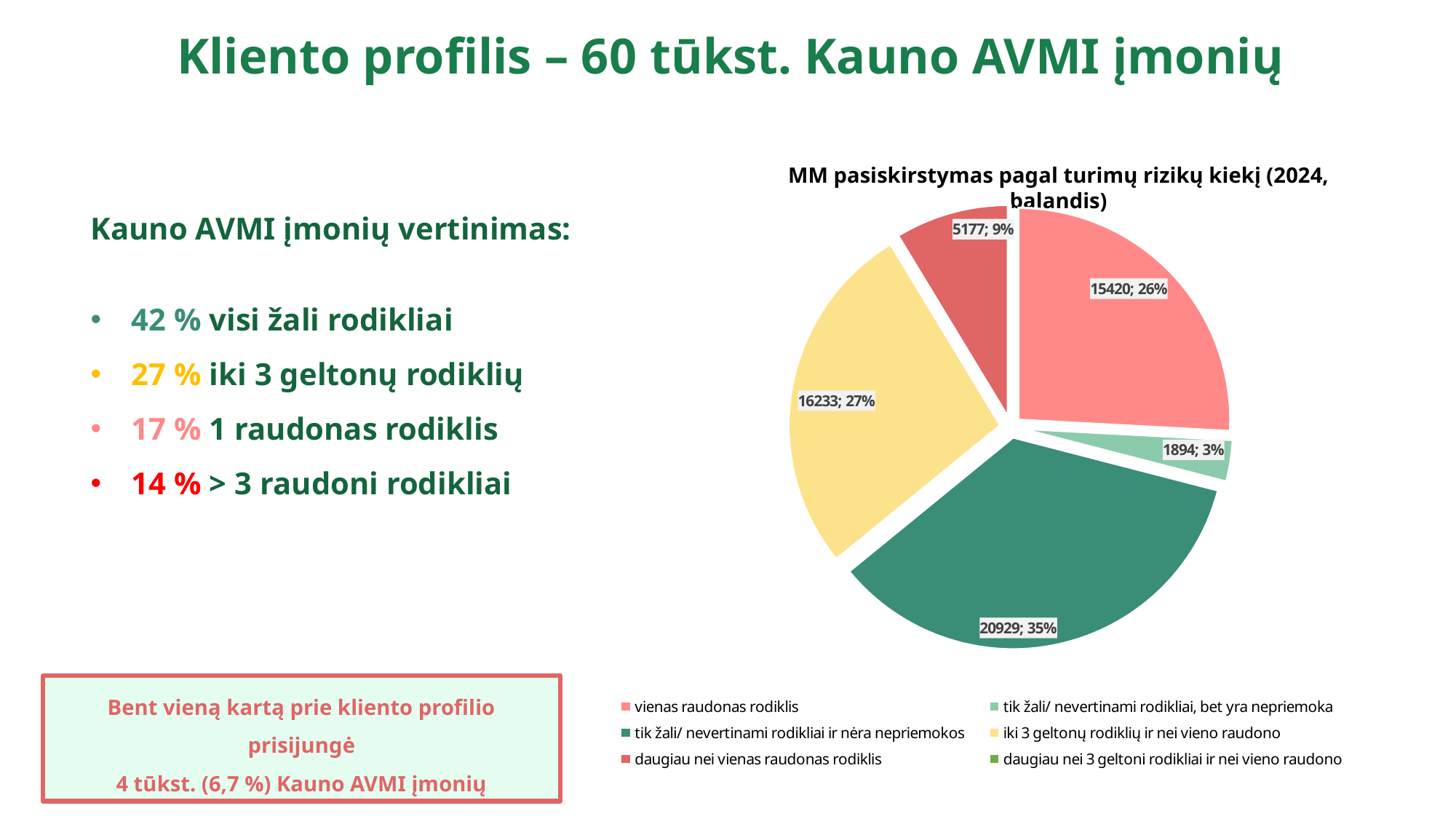
What value is shown for the slice "daugiau nei vienas raudonas rodiklis"? 5177; 9% Which category has the largest slice of the pie? tik žali/ nevertinami rodikliai ir nėra nepriemokos Which visible slice of the pie is the smallest? tik žali/ nevertinami rodikliai, bet yra nepriemoka What value is shown for the slice "iki 3 geltonų rodiklių ir nei vieno raudono"? 16233; 27% What is the difference between the values for "tik žali/ nevertinami rodikliai ir nėra nepriemokos" and "vienas raudonas rodiklis"? 5509 What value is shown for the slice "tik žali/ nevertinami rodikliai ir nėra nepriemokos"? 20929; 35% How many entries does the chart legend list? 6 What is the title of the chart? MM pasiskirstymas pagal turimų rizikų kiekį (2024, balandis) What share of the pie does the slice "tik žali/ nevertinami rodikliai, bet yra nepriemoka" represent? 3% What kind of chart is shown on the slide? pie chart What value is shown for the slice "vienas raudonas rodiklis"? 15420; 26% Which is larger: the slice for "iki 3 geltonų rodiklių ir nei vieno raudono" or the slice for "vienas raudonas rodiklis"? iki 3 geltonų rodiklių ir nei vieno raudono